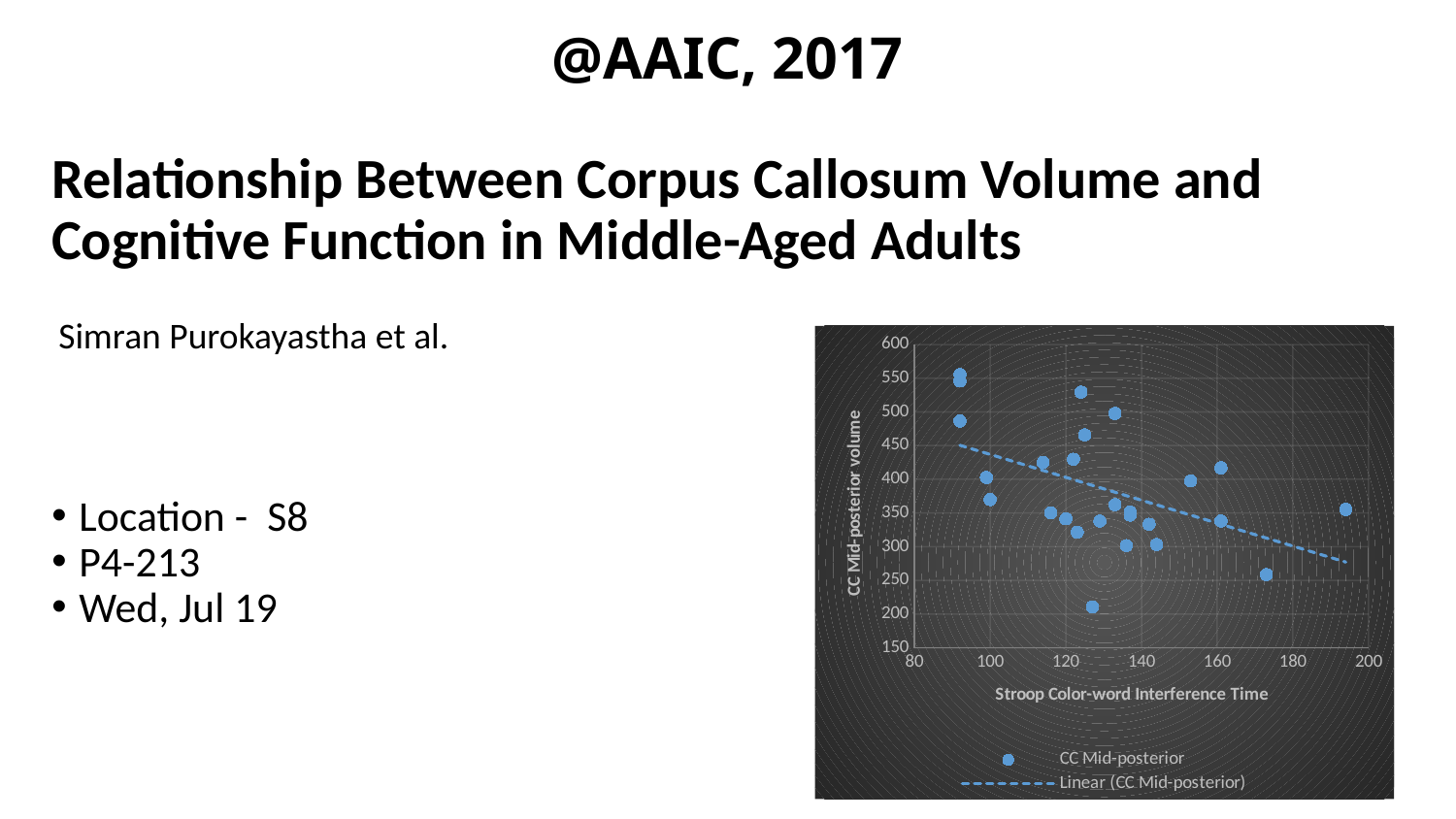
What is the highest tick value shown on the x axis of the chart? 200 Is the CC Mid-posterior volume of the highest point on the chart greater or less than 500? greater What is the title of the x axis of the chart? Stroop Color-word Interference Time Is the Stroop Color-word Interference Time of the lowest point on the chart greater or less than 140? less Does the dashed trend line rise or fall as Stroop Color-word Interference Time increases? fall What kind of chart is shown on the slide? scatter chart How many entries does the chart legend list? 2 What is the title of the y axis of the chart? CC Mid-posterior volume Is the CC Mid-posterior volume of the rightmost point (near 195 on the x axis) greater or less than 300? greater